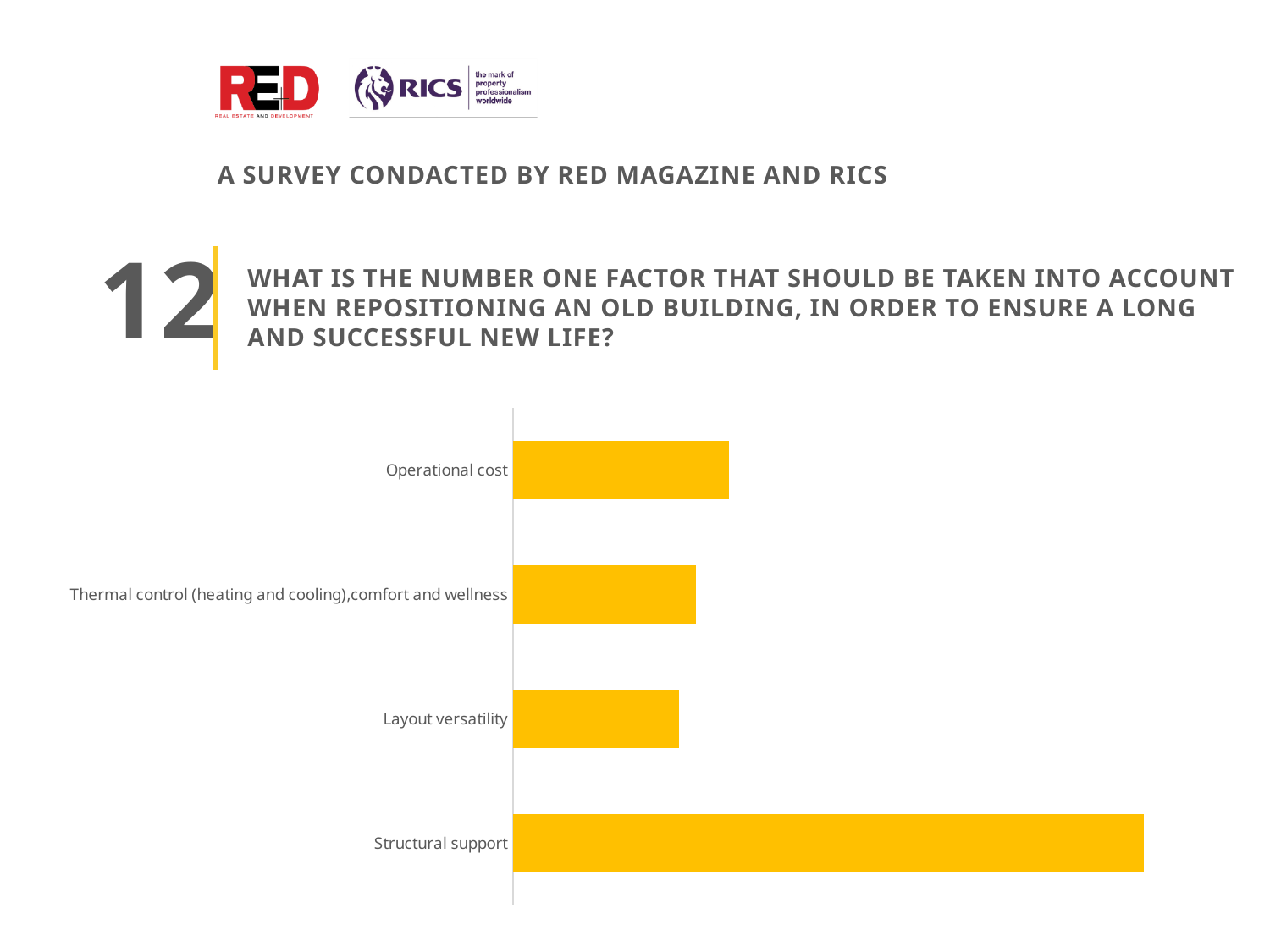
Are the bars in the chart horizontal or vertical? horizontal Which is larger, the value for Structural support or the value for Thermal control (heating and cooling), comfort and wellness? Structural support How many categories are plotted in the chart? 4 Which is larger, the value for Structural support or the value for Operational cost? Structural support Which category has the highest value in the chart? Structural support What colour are the bars in the chart? yellow What kind of chart is shown on the slide? bar chart Which is larger, the value for Structural support or the value for Layout versatility? Structural support